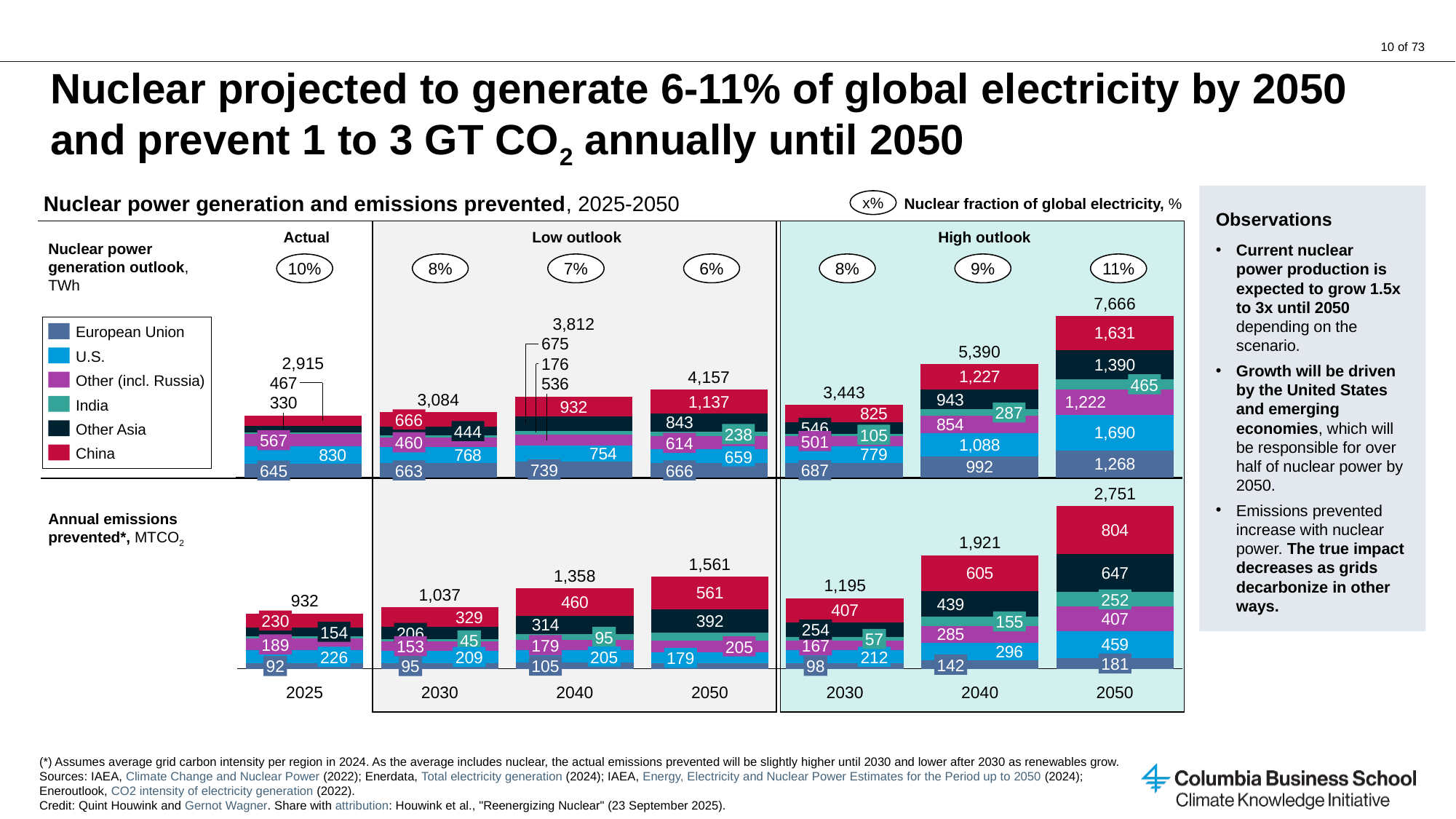
What kind of chart is the 'Nuclear power generation outlook, TWh' chart? Stacked bar chart In the 'Annual emissions prevented, MTCO2' chart, what is the total for the low outlook in 2040? 1,358 In the 'Annual emissions prevented, MTCO2' chart, which bar has the lowest total? Actual 2025 What nuclear fraction of global electricity is shown for the high outlook in 2050? 11% In the 'Nuclear power generation outlook, TWh' chart, which bar has the highest total? High outlook 2050 How many series does the legend list? 6 In the 'Annual emissions prevented, MTCO2' chart, what is the difference between the high outlook 2050 total and the actual 2025 total? 1,819 In the 'Nuclear power generation outlook, TWh' chart, what is the difference between the high outlook 2050 total and the actual 2025 total? 4,751 In the 'Nuclear power generation outlook, TWh' chart, which is larger: the low outlook 2050 total or the high outlook 2030 total? Low outlook 2050 In the 'Nuclear power generation outlook, TWh' chart, what is the U.S. value for the high outlook in 2050? 1,690 In the 'Nuclear power generation outlook, TWh' chart, what is the total for the high outlook in 2050? 7,666 In the 'Annual emissions prevented, MTCO2' chart, what is the China value for the actual 2025 bar? 230